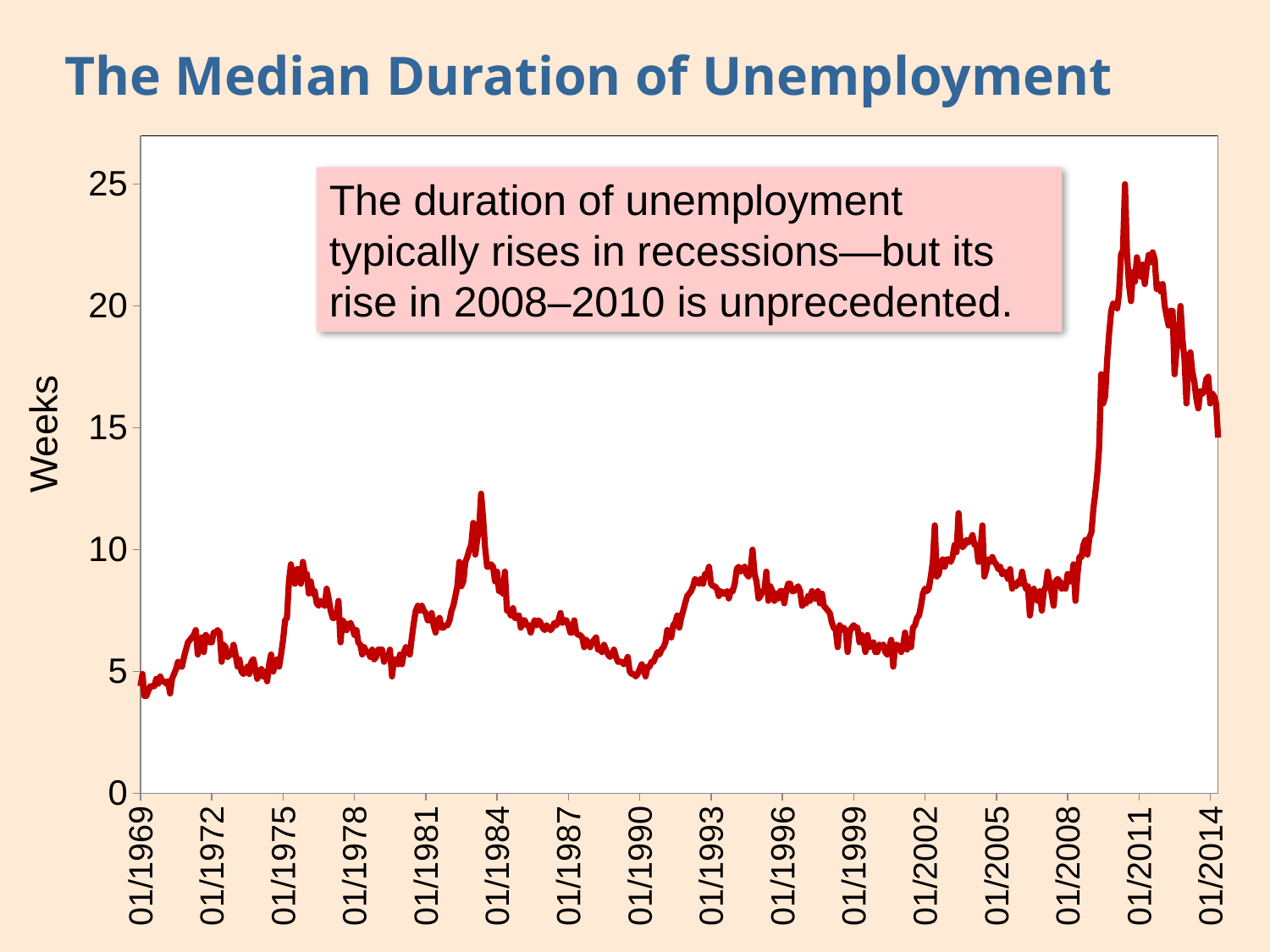
How many date labels are shown on the x-axis? 16 What kind of chart is shown on the slide? line chart Is the highest point on the line greater or less than 20? greater Is the value at 01/1990 greater or less than 10? less Does the line rise or fall between 01/2008 and 01/2011? rise What is the title of the chart on the slide? The Median Duration of Unemployment Does the line rise or fall between 01/2011 and 01/2014? fall Is the value at 01/2011 greater or less than 20? greater Which is larger, the value at 01/2011 or the value at 01/1984? 01/2011 What unit is shown on the y-axis label of the chart? Weeks